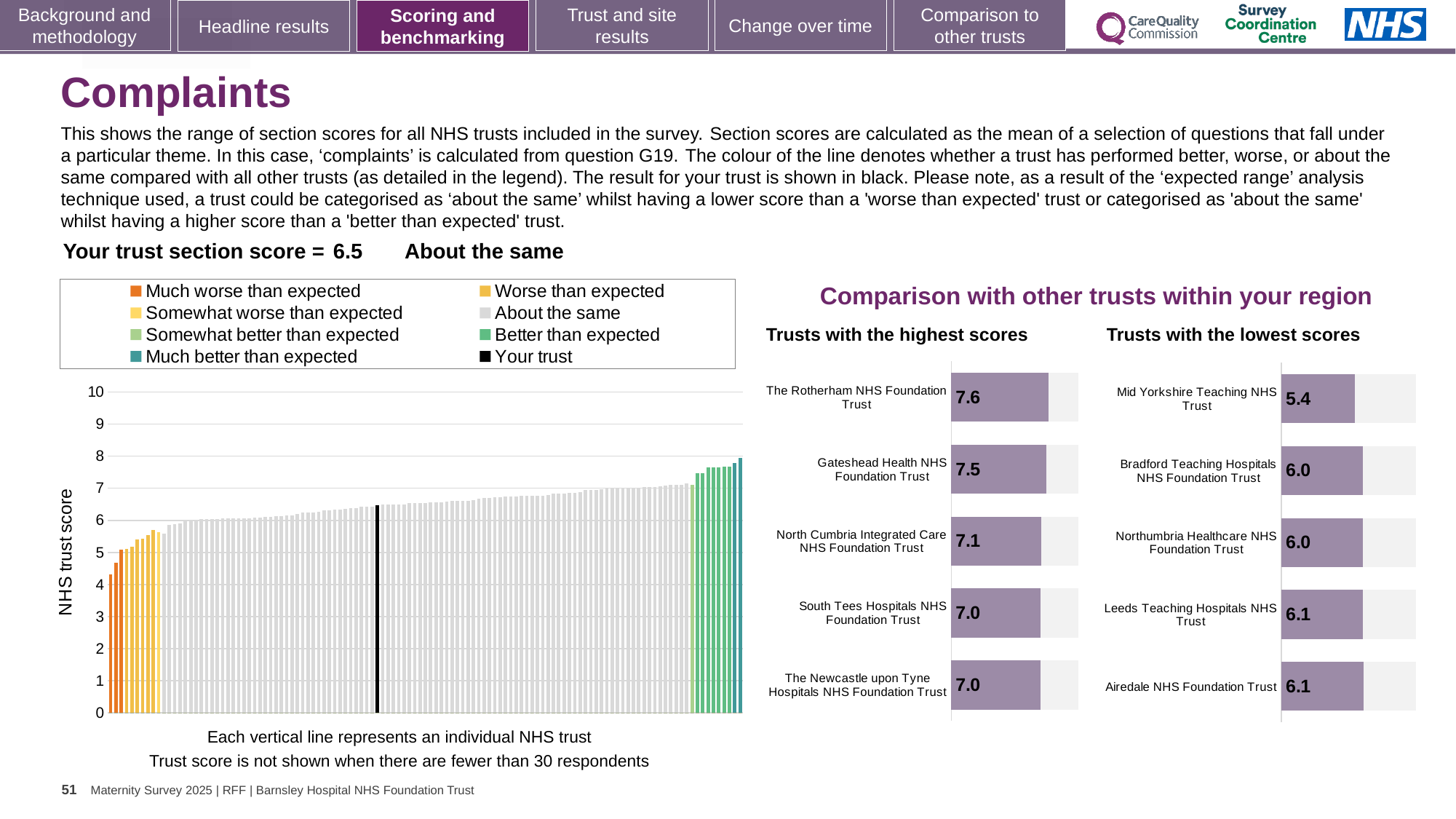
In the 'Trusts with the lowest scores' chart, which trust has the lowest score? Mid Yorkshire Teaching NHS Trust In the NHS trust score chart on the left, do the bar values rise or fall from left to right? rise In the 'Trusts with the lowest scores' chart, what is the difference between the scores of Airedale NHS Foundation Trust and Mid Yorkshire Teaching NHS Trust? 0.7 In the 'Trusts with the highest scores' chart, which trust has the highest score? The Rotherham NHS Foundation Trust In the 'Trusts with the lowest scores' chart, what is the score for Mid Yorkshire Teaching NHS Trust? 5.4 In the 'Trusts with the highest scores' chart, which has the larger score: Gateshead Health NHS Foundation Trust or North Cumbria Integrated Care NHS Foundation Trust? Gateshead Health NHS Foundation Trust In the 'Trusts with the highest scores' chart, what is the difference between the scores of The Rotherham NHS Foundation Trust and Gateshead Health NHS Foundation Trust? 0.1 In the NHS trust score chart on the left, is the value of the lowest bar greater or less than 5? less In the 'Trusts with the highest scores' chart, what is the score for The Rotherham NHS Foundation Trust? 7.6 In the NHS trust score chart on the left, what is the section score for your trust? 6.5 How many entries does the legend above the NHS trust score chart list? 8 In the 'Trusts with the highest scores' chart, how many trusts are listed? 5